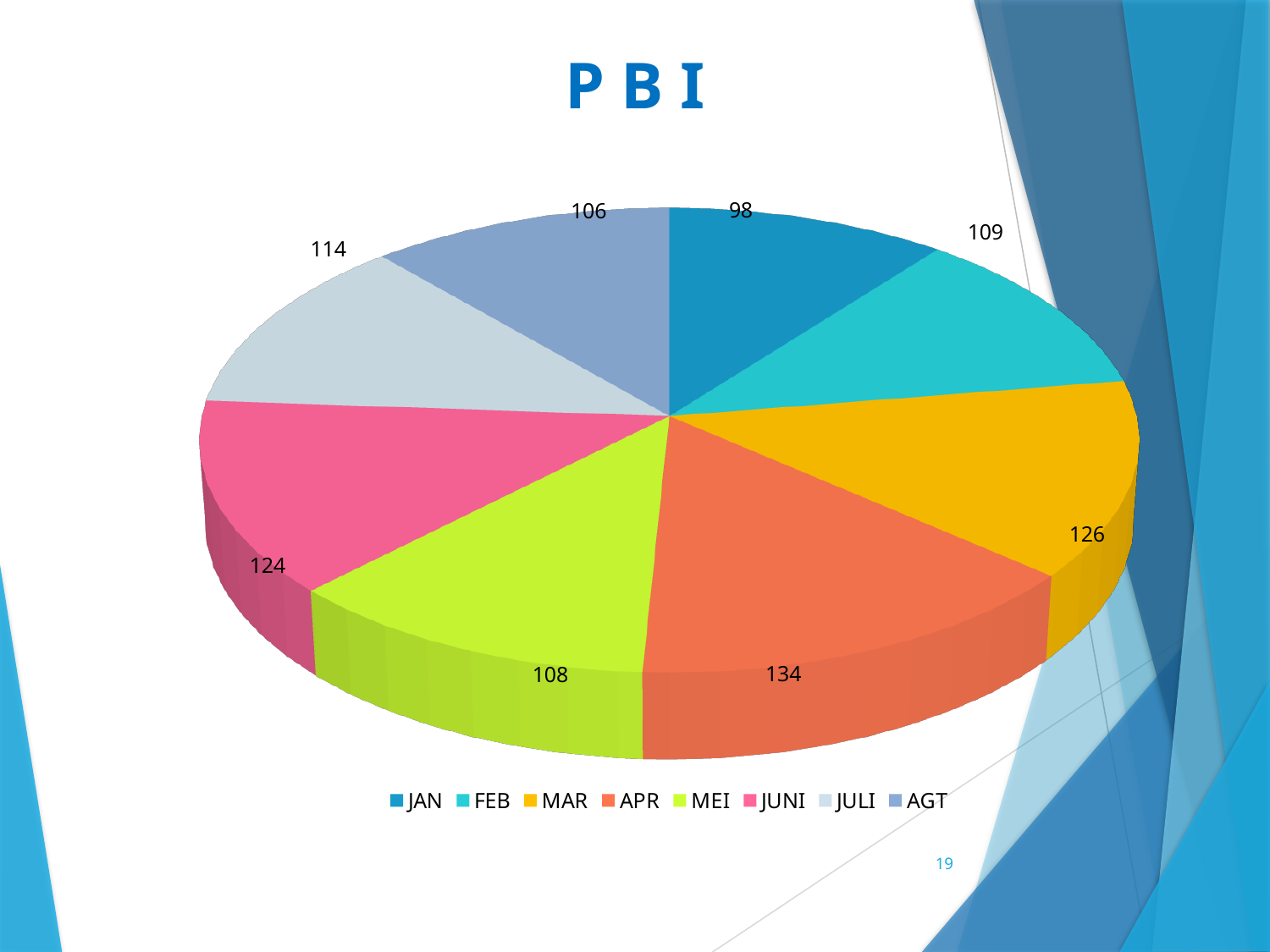
What is the value for MAR? 126 What is the value for JAN? 98 Which month has the smallest slice? JAN Which month has the largest slice? APR How many slices does the pie chart have? 8 What is the title of the chart? P B I What is the value for APR? 134 What is the difference between the values for APR and JAN? 36 What kind of chart is shown on the slide? Pie chart What is the value for JULI? 114 What is the difference between the values for MAR and JUNI? 2 Which is larger, the value for FEB or the value for AGT? FEB